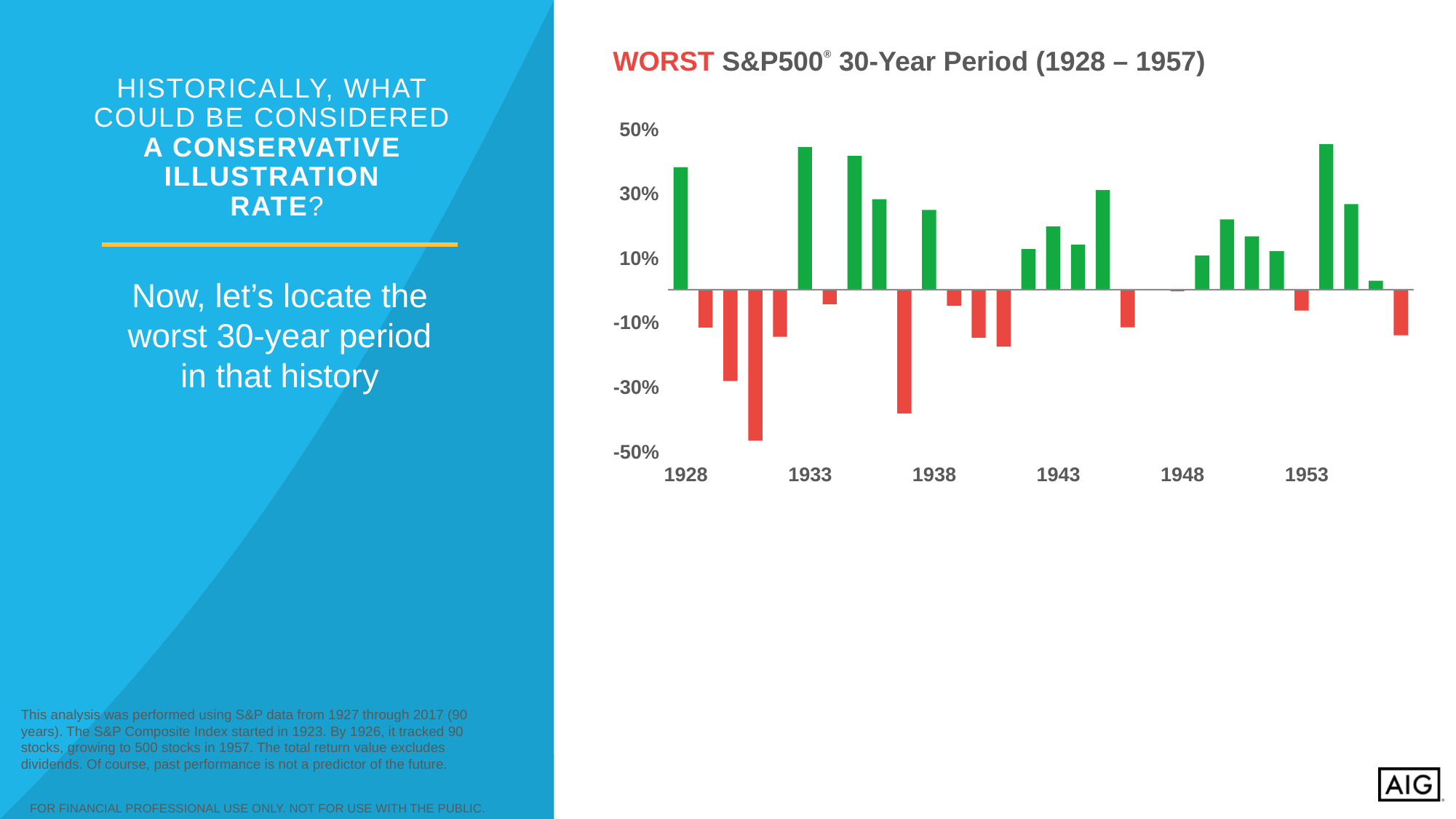
Is the value for 1933 greater or less than 30%? greater Is the value for 1928 greater or less than 30%? greater What is the title of the chart? WORST S&P500 30-Year Period (1928 – 1957) What type of chart is shown on the slide? bar chart What colour are the bars with negative values? red Is the value for 1943 greater or less than 30%? less Of the years labeled on the x axis, which has the highest value? 1933 Which is larger, the value for 1928 or the value for 1938? 1928 Which is larger, the value for 1943 or the value for 1953? 1943 Of the years labeled on the x axis, which has the lowest value? 1953